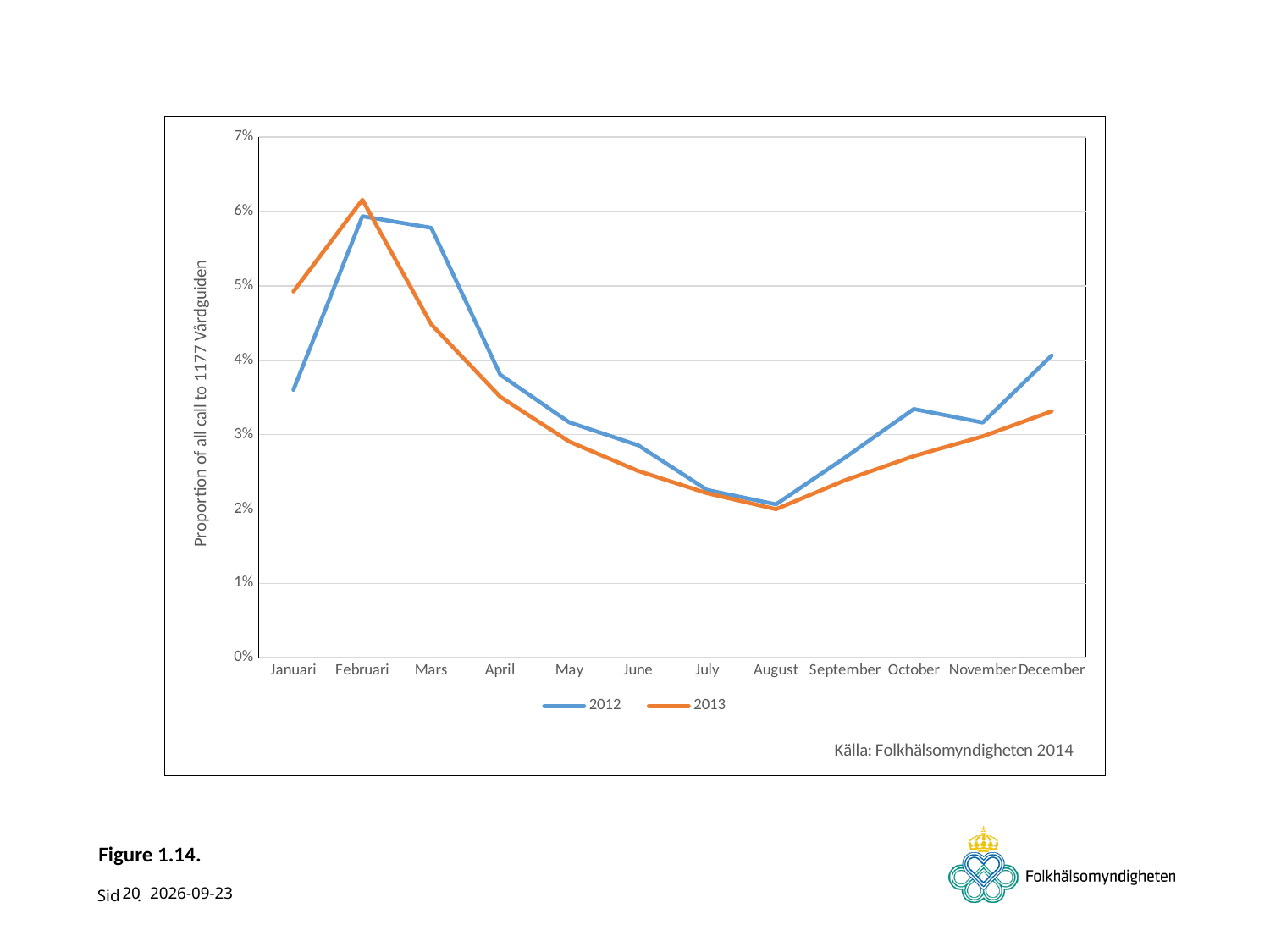
Is the value for 2013 in Januari greater or less than 4%? greater In which month does the 2012 series reach its lowest value? August In which month does the 2013 series reach its highest value? Februari In Mars, which series has the higher value, 2012 or 2013? 2012 What kind of chart is shown on the slide? line chart In Januari, which series has the higher value, 2012 or 2013? 2013 Does the 2012 series rise or fall from Februari to August? fall How many months are shown on the x axis? 12 Is the value for 2012 in Mars greater or less than 5%? greater How many series does the legend list? 2 What is the title of the y axis? Proportion of all call to 1177 Vårdguiden Is the value for 2013 in August greater or less than 3%? less